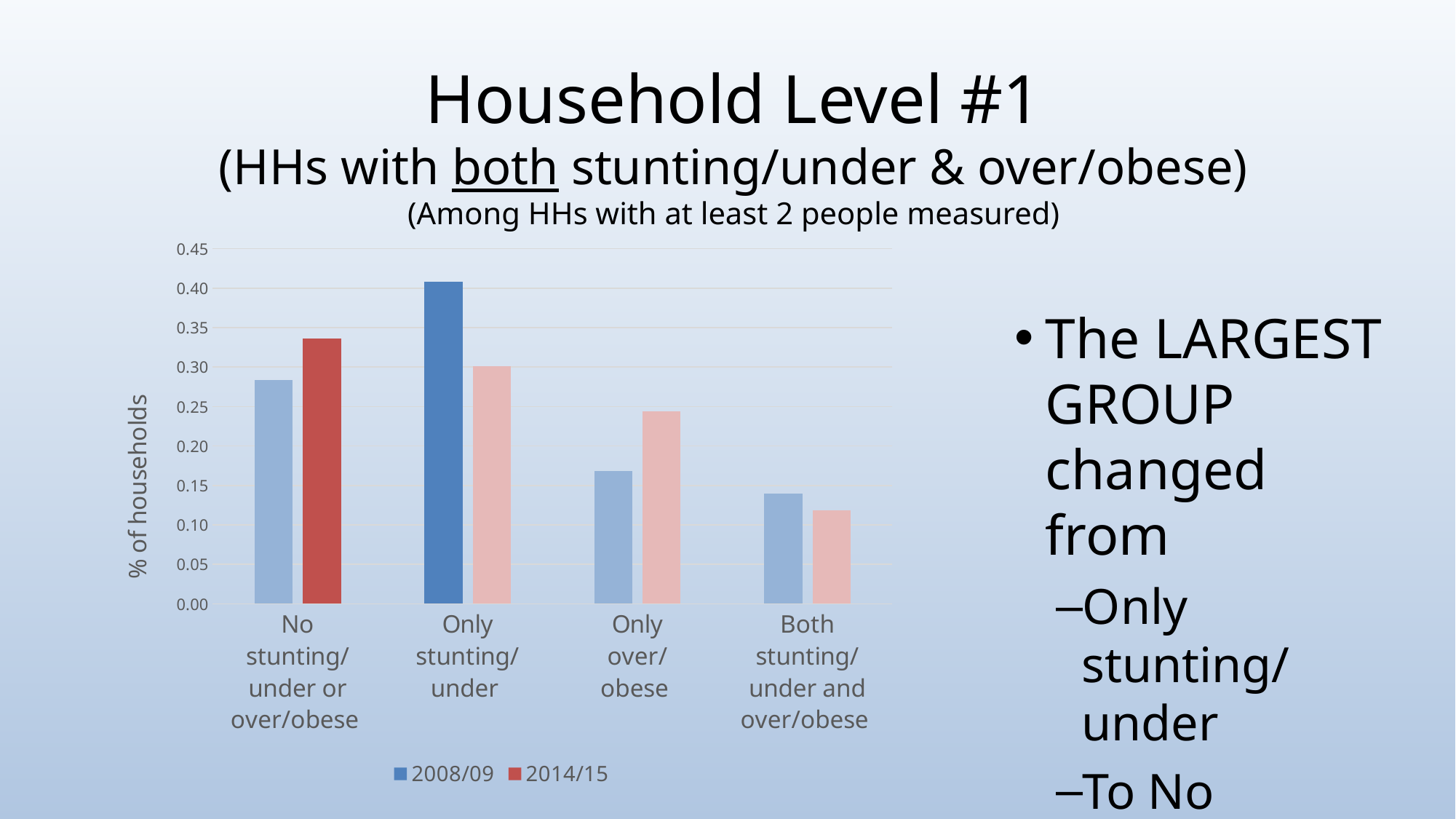
What is the label on the y axis of the chart? % of households Which category has the highest value for the 2008/09 series? Only stunting/under Which category has the lowest value for the 2014/15 series? Both stunting/under and over/obese How many series does the chart legend list? 2 Which category has the highest value for the 2014/15 series? No stunting/under or over/obese How many household categories are shown on the x axis of the chart? 4 For the No stunting/under or over/obese category, which series has the larger value, 2008/09 or 2014/15? 2014/15 For the Only stunting/under category, which series has the larger value, 2008/09 or 2014/15? 2008/09 What kind of chart is shown on the slide? Bar chart Is the 2008/09 value for Only stunting/under greater or less than 0.35? greater Is the 2014/15 value for Only over/obese greater or less than 0.20? greater Which category has the lowest value for the 2008/09 series? Both stunting/under and over/obese